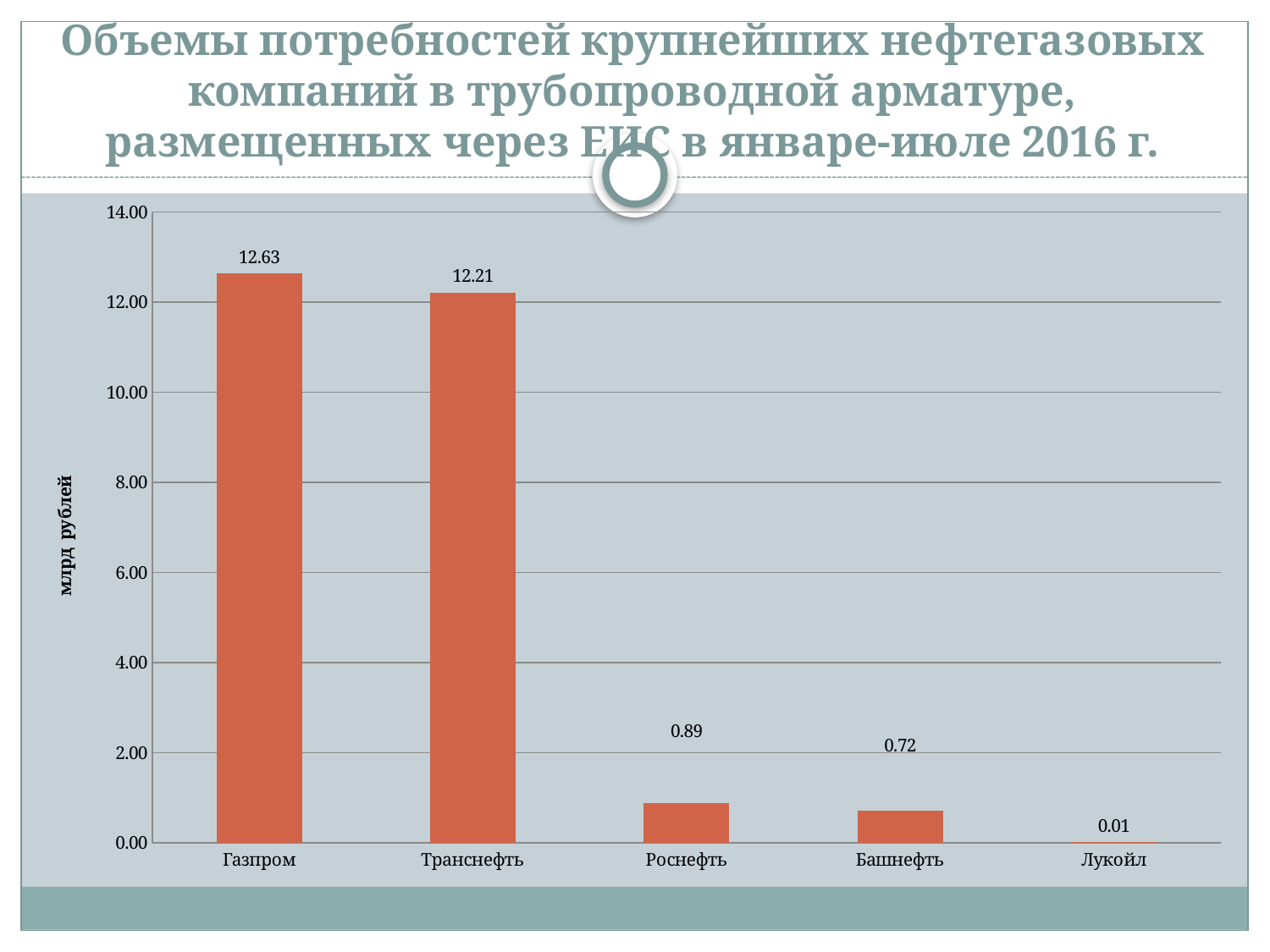
What is the value for Башнефть? 0.72 Which company has the lowest value? Лукойл What is the label of the vertical axis? млрд рублей Is the value for Транснефть greater or less than 12.00? greater What is the value for Роснефть? 0.89 Which is larger, the value for Роснефть or the value for Башнефть? Роснефть What is the value for Транснефть? 12.21 How many companies are shown on the chart? 5 Which company has the highest value? Газпром What is the difference between the values for Газпром and Транснефть? 0.42 What is the value for Лукойл? 0.01 What is the value for Газпром? 12.63